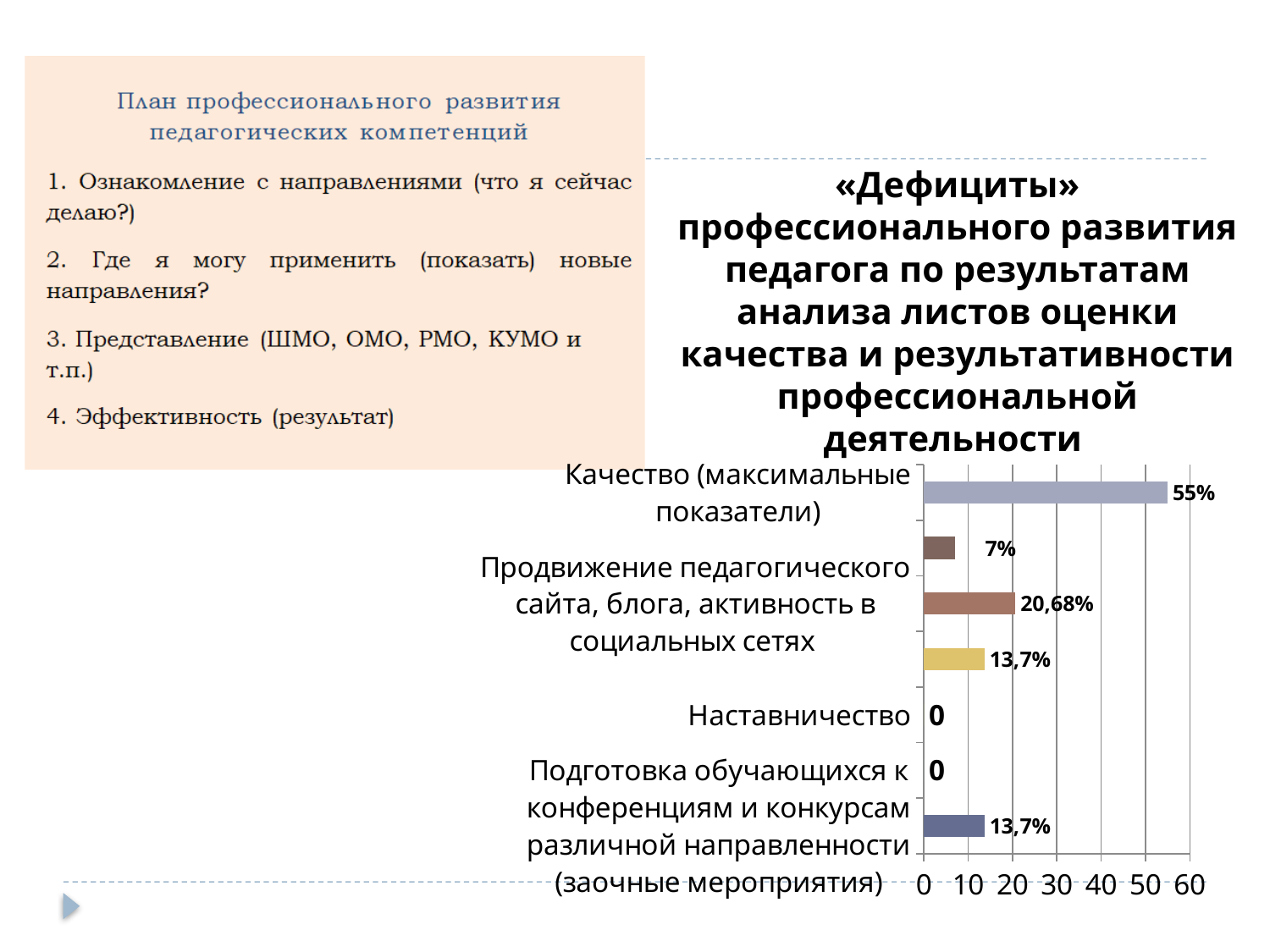
Which is larger: the value for «Качество (максимальные показатели)» or for «Продвижение педагогического сайта, блога, активность в социальных сетях»? Качество (максимальные показатели) What is the value for «Наставничество»? 0 What is the largest value shown in the chart? 55% What is the value for «Подготовка обучающихся к конференциям и конкурсам различной направленности (заочные мероприятия)»? 13,7% How many bars (categories) are plotted in the chart? 7 Is the value for «Качество (максимальные показатели)» greater or less than 50? greater What is the value for «Продвижение педагогического сайта, блога, активность в социальных сетях»? 20,68% How many categories in the chart have a value of 0? 2 What is the value for «Качество (максимальные показатели)»? 55% What kind of chart is shown on the slide? bar chart Which category has the highest value in the chart? Качество (максимальные показатели) What is the difference between the value for «Качество (максимальные показатели)» and the value for «Продвижение педагогического сайта, блога, активность в социальных сетях»? 34,32%